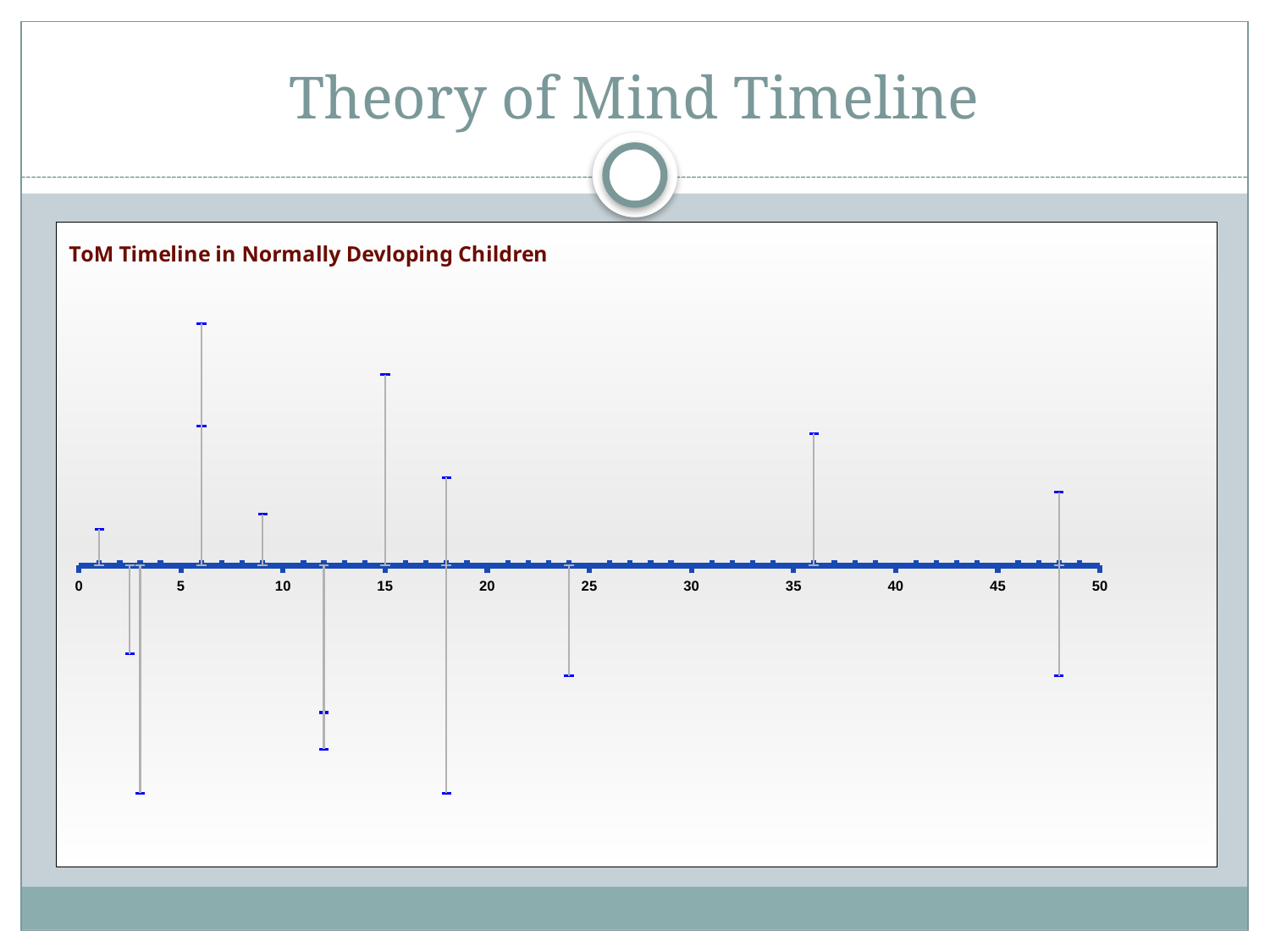
At which horizontal-axis position does the stem that rises highest above the axis occur? 6 What is the largest value labelled on the horizontal axis of the chart? 50 What is the title of the chart on the slide? ToM Timeline in Normally Devloping Children